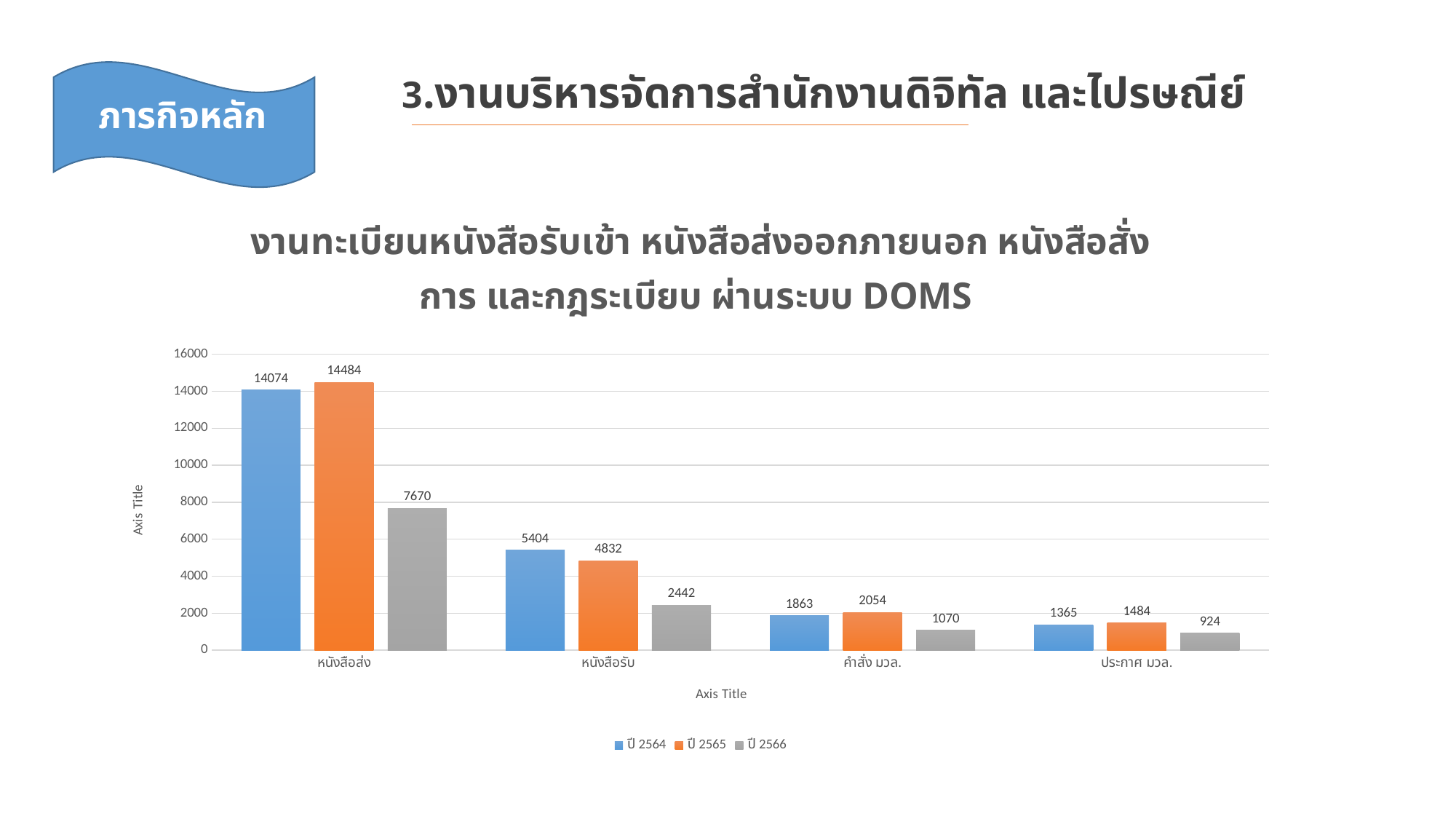
Which is larger for คำสั่ง มวล.: the ปี 2564 value or the ปี 2565 value? ปี 2565 What is the difference between the ปี 2565 and ปี 2566 values for หนังสือส่ง? 6814 Which series is shown in orange in the legend? ปี 2565 What is the value for หนังสือรับ in ปี 2566? 2442 How many series does the legend list? 3 Which category has the lowest value in ปี 2566? ประกาศ มวล. Which category has the highest value in ปี 2564? หนังสือส่ง How many categories are shown on the x axis? 4 What is the value for คำสั่ง มวล. in ปี 2564? 1863 What is the value for ประกาศ มวล. in ปี 2566? 924 What kind of chart is shown on the slide? bar chart What is the value for หนังสือส่ง in ปี 2565? 14484